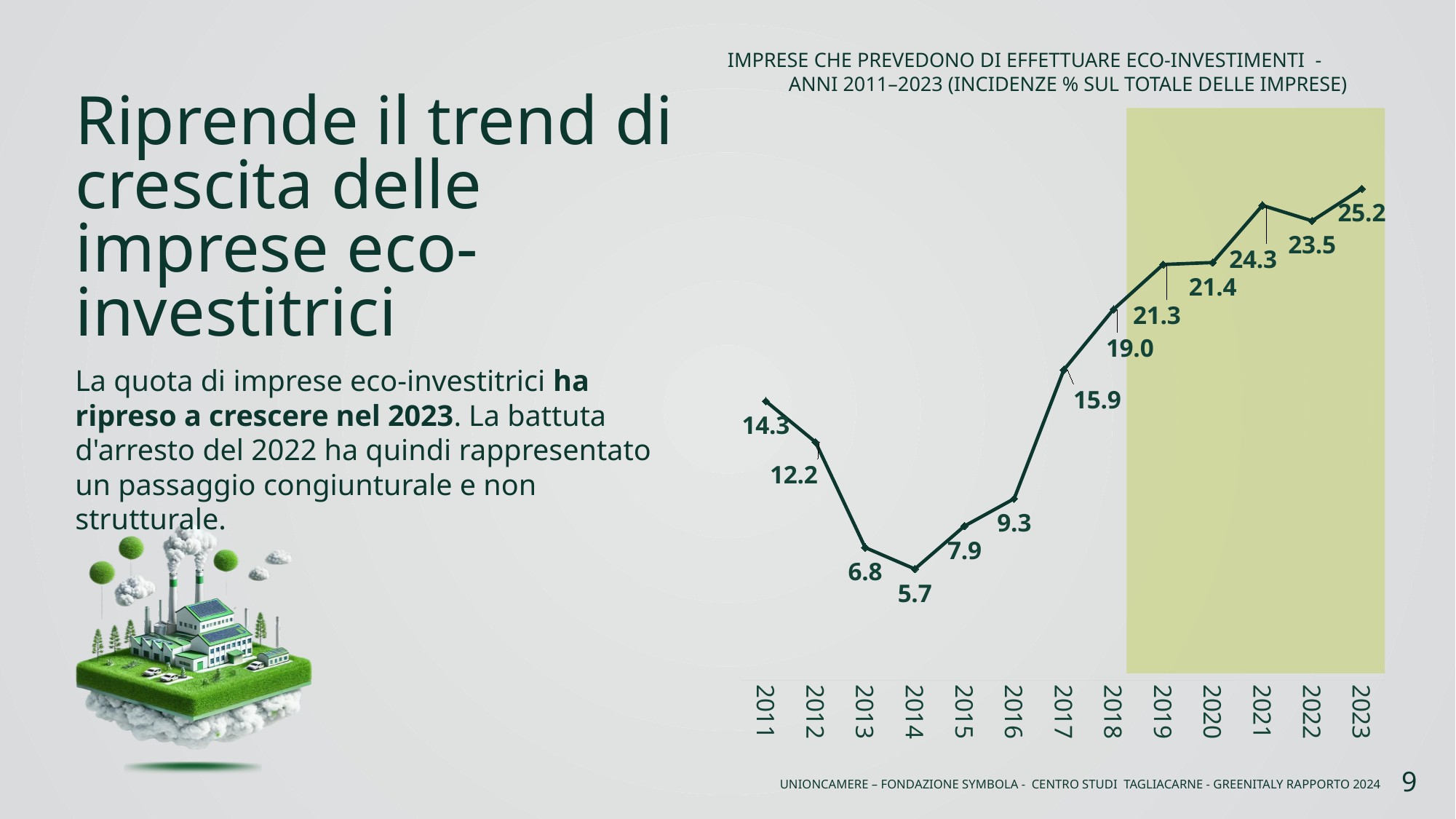
How many years are plotted on the chart? 13 Which year has the highest value? 2023 Which year has the lowest value? 2014 What is the value for 2014? 5.7 What kind of chart is shown? line chart What is the value for 2011? 14.3 Do the values rise or fall from 2014 to 2021? rise Which is larger, the value for 2021 or the value for 2022? 2021 What is the value for 2019? 21.3 What is the difference between the values for 2018 and 2017? 3.1 What is the difference between the values for 2023 and 2022? 1.7 What is the value for 2023? 25.2